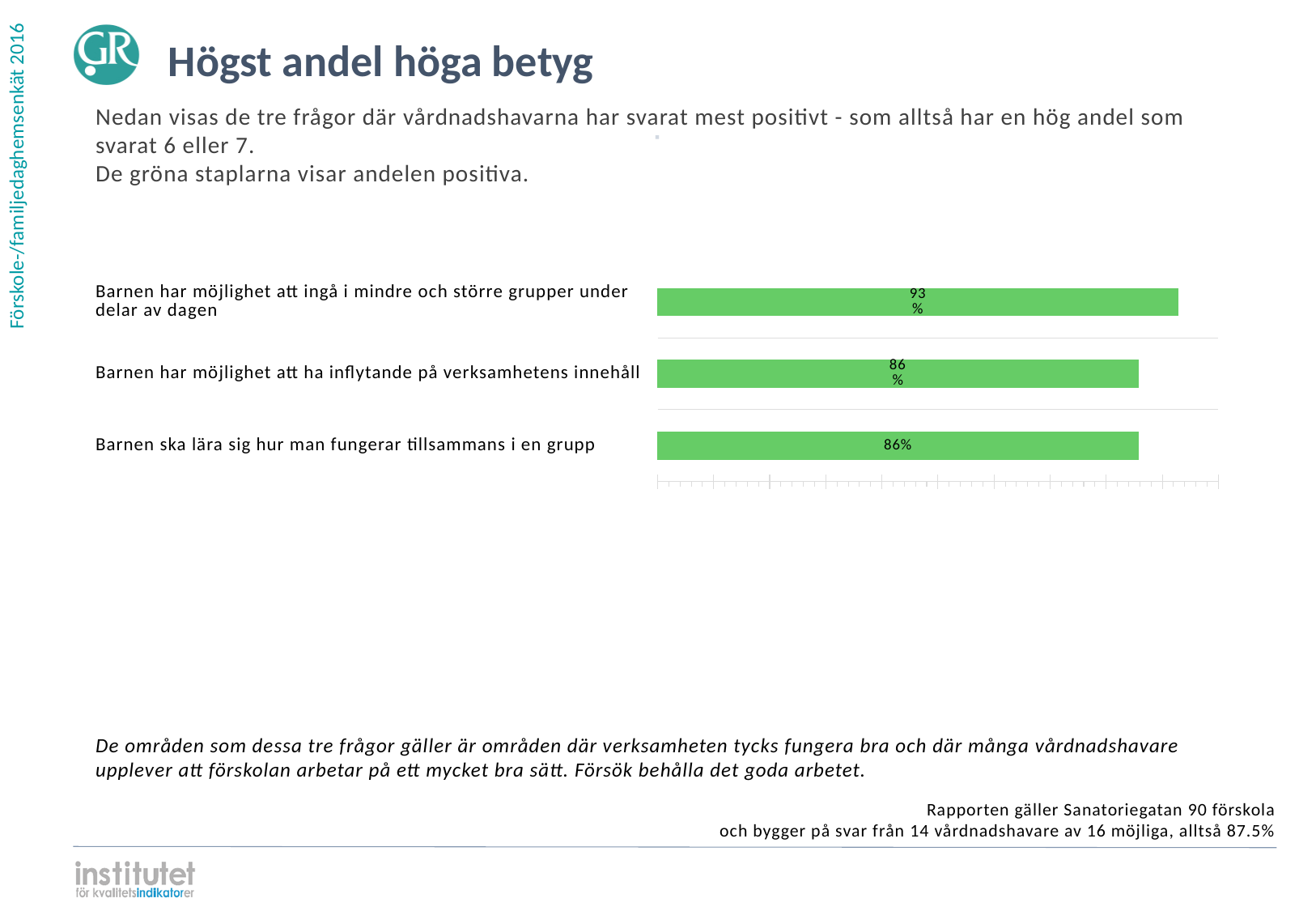
What is the title of the slide? Högst andel höga betyg What colour are the bars in the chart? Green What is the difference between the value for "Barnen har möjlighet att ingå i mindre och större grupper under delar av dagen" and the value for "Barnen ska lära sig hur man fungerar tillsammans i en grupp"? 7% What is the value for "Barnen har möjlighet att ingå i mindre och större grupper under delar av dagen"? 93% Which category has the highest value? Barnen har möjlighet att ingå i mindre och större grupper under delar av dagen Which is larger: the value for "Barnen har möjlighet att ingå i mindre och större grupper under delar av dagen" or the value for "Barnen har möjlighet att ha inflytande på verksamhetens innehåll"? Barnen har möjlighet att ingå i mindre och större grupper under delar av dagen How many categories are shown in the chart? 3 What is the value for "Barnen ska lära sig hur man fungerar tillsammans i en grupp"? 86% What kind of chart is shown on the slide? Bar chart What is the value for "Barnen har möjlighet att ha inflytande på verksamhetens innehåll"? 86%